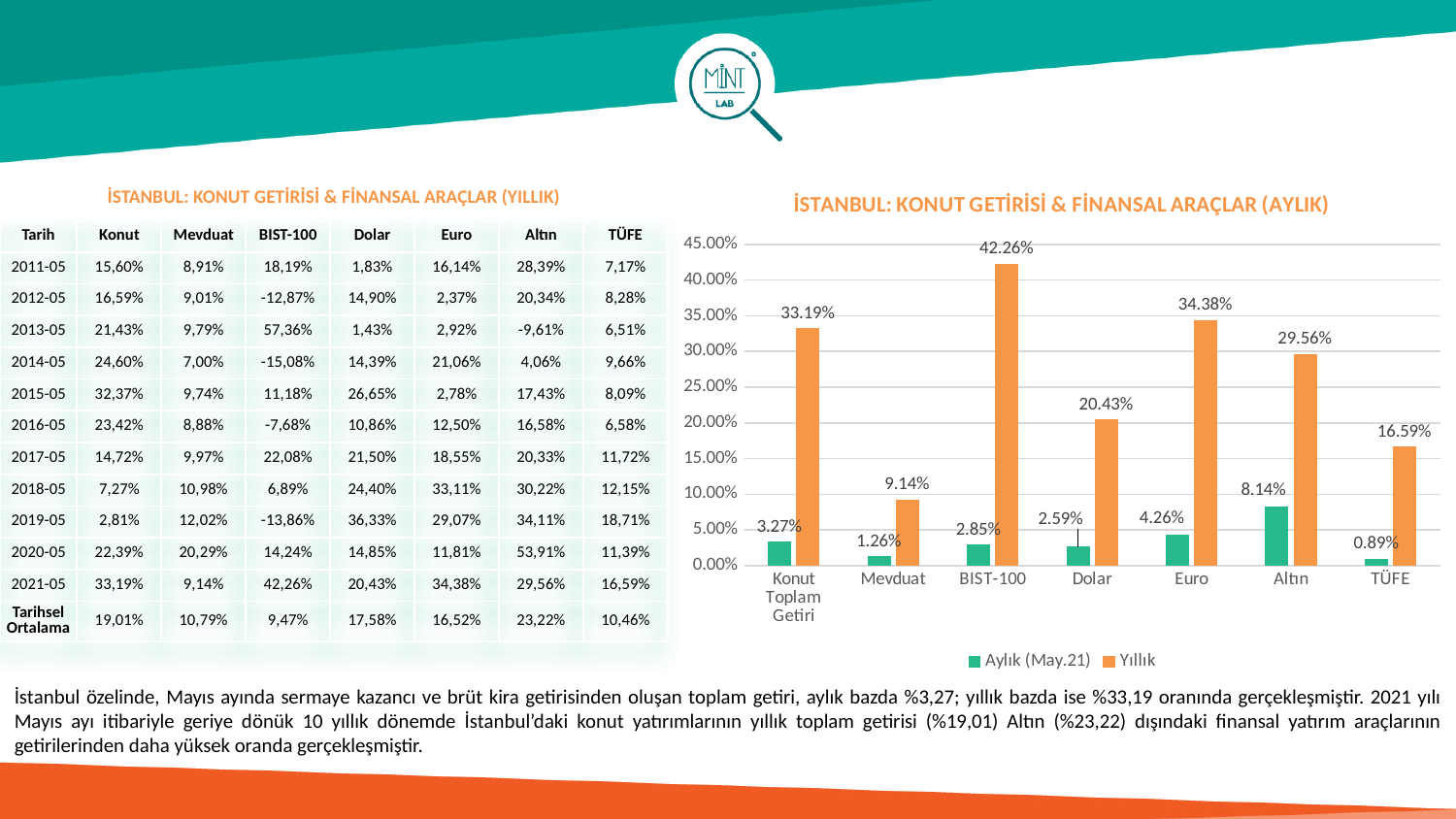
Which is larger, the Yıllık value for Konut Toplam Getiri or the Yıllık value for Altın? Konut Toplam Getiri What is the Aylık (May.21) value for Altın? 8.14% What is the title of the chart? İSTANBUL: KONUT GETİRİSİ & FİNANSAL ARAÇLAR (AYLIK) What is the Yıllık value for Konut Toplam Getiri? 33.19% What type of chart is shown on the slide? bar chart How many categories are shown on the x axis of the chart? 7 How many series does the chart legend list? 2 What is the difference between the Yıllık values for Euro and Dolar? 13.95% What is the Yıllık value for BIST-100? 42.26% Which category has the lowest Aylık (May.21) value? TÜFE Which category has the highest Yıllık value? BIST-100 Is the Yıllık value for Mevduat greater or less than 10.00%? less